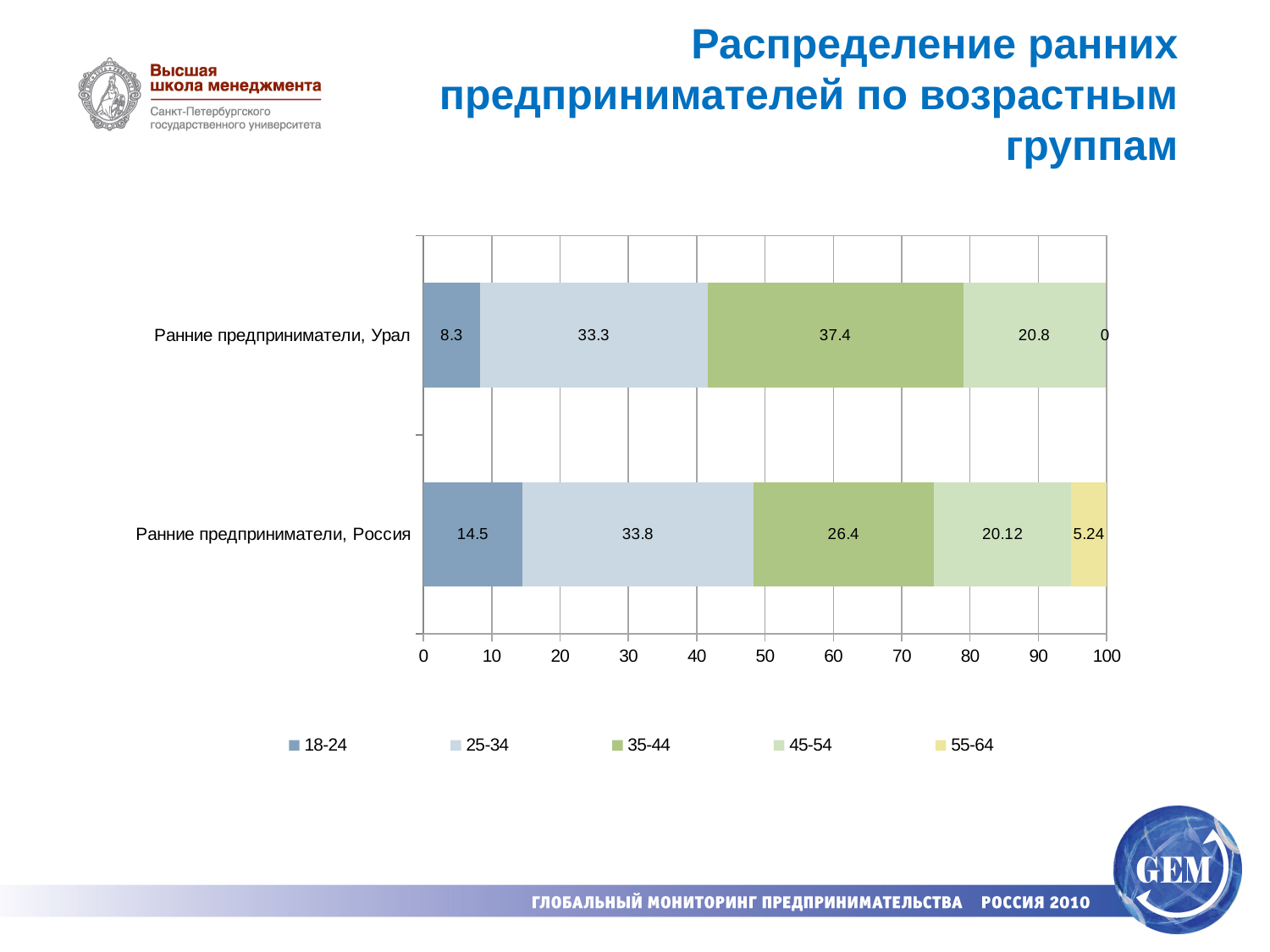
Which age group has the largest share for Ранние предприниматели, Урал? 35-44 What is the value for the 45-54 age group for Ранние предприниматели, Россия? 20.12 What is the difference between the 35-44 values for Урал and Россия? 11 What is the value for the 35-44 age group for Ранние предприниматели, Урал? 37.4 How much larger is the 18-24 value for Ранние предприниматели, Россия than for Ранние предприниматели, Урал? 6.2 What is the value for the 18-24 age group for Ранние предприниматели, Россия? 14.5 What is the value for the 55-64 age group for Ранние предприниматели, Урал? 0 Which age group has the smallest share for Ранние предприниматели, Россия? 55-64 How many categories (bars) are shown on the chart? 2 Which has the larger 25-34 value: Ранние предприниматели, Урал or Ранние предприниматели, Россия? Ранние предприниматели, Россия What kind of chart is shown on the slide? Stacked bar chart How many series does the legend list? 5